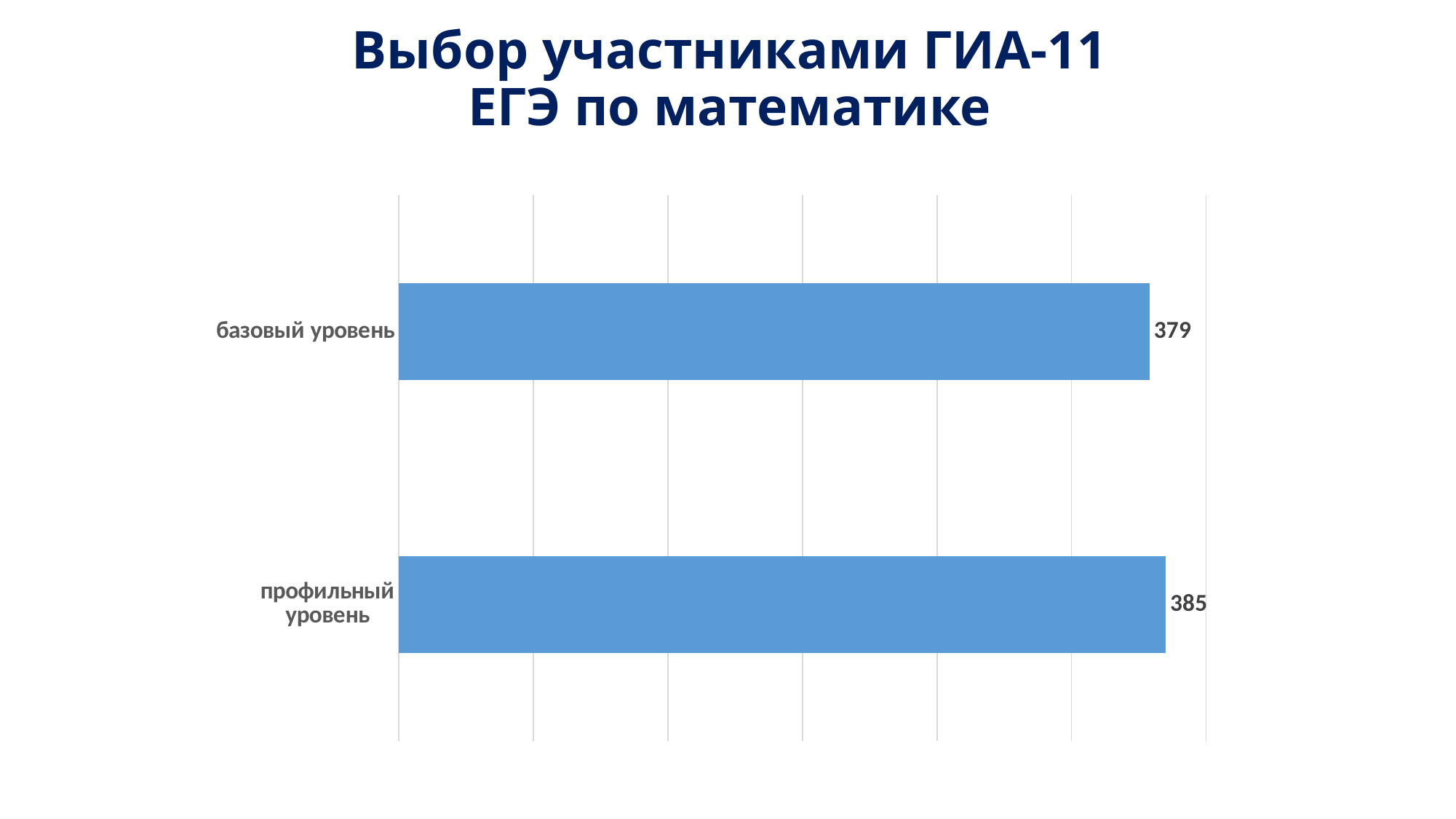
Which category has the highest value? профильный уровень Which is larger, the value for базовый уровень or the value for профильный уровень? профильный уровень What is the total of the two values shown in the chart? 764 What is the value for профильный уровень? 385 What kind of chart is shown on the slide? bar chart What is the difference between the values for профильный уровень and базовый уровень? 6 What is the title of the chart on the slide? Выбор участниками ГИА-11 ЕГЭ по математике How many categories are shown in the chart? 2 What is the value for базовый уровень? 379 What colour are the bars in the chart? blue Which category has the lowest value? базовый уровень